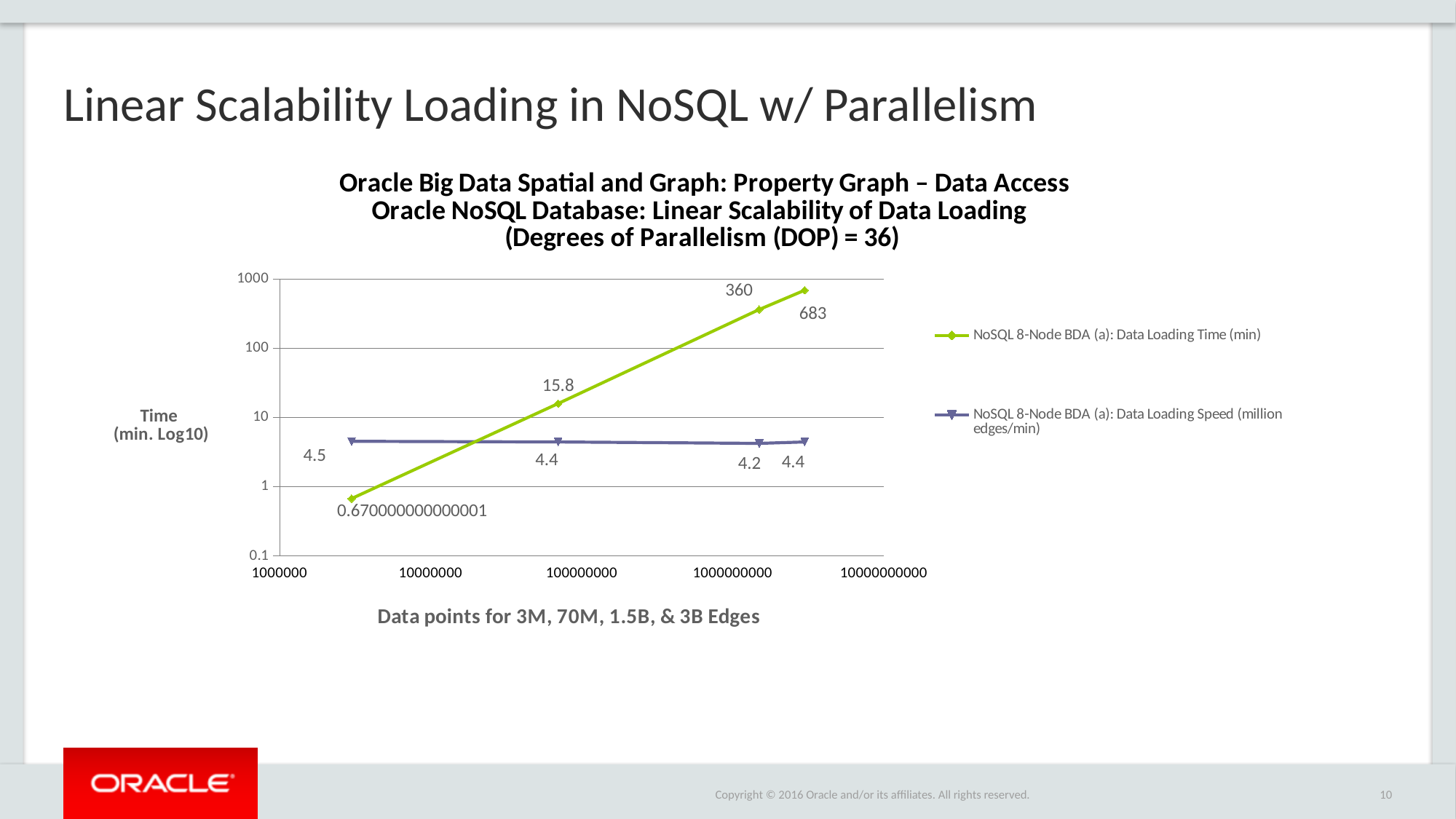
What is the lowest Data Loading Time (min) value shown? 0.670000000000001 What kind of chart is shown on the slide? line chart What is the Data Loading Time (min) value at the rightmost data point (3B edges)? 683 What value of Degrees of Parallelism (DOP) is stated in the chart title? 36 What is the Data Loading Time (min) value at the second data point (70M edges)? 15.8 How many series does the legend list? 2 What is the highest Data Loading Speed (million edges/min) value shown? 4.5 How many data points are plotted for the Data Loading Time (min) series? 4 What is the Data Loading Speed (million edges/min) value at the third data point (1.5B edges)? 4.2 What is the difference between the Data Loading Time values at the fourth and third data points (683 and 360)? 323 Does the Data Loading Time (min) series rise or fall as the number of edges increases along the x axis? rise Which is larger at the second data point: the Data Loading Time (min) or the Data Loading Speed (million edges/min)? Data Loading Time (min)